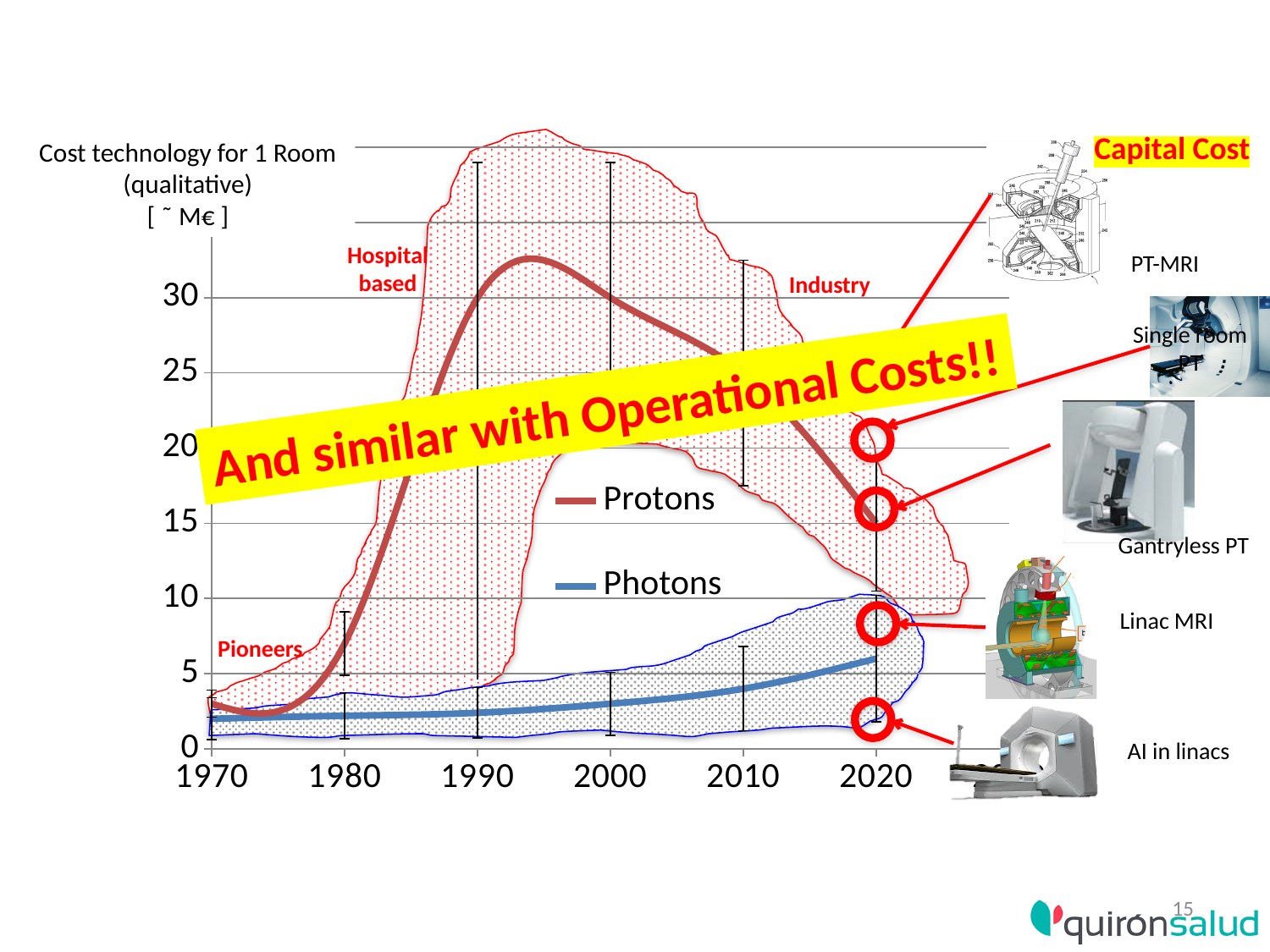
Is the value of the Photons line at 2020 greater or less than 10? less Is the value of the Protons line at 2020 greater or less than 10? greater How many series does the chart legend list? 2 Which series reaches the highest value on the chart? Protons What kind of chart is shown on the slide? line chart At 2020, which series has the larger value, Protons or Photons? Protons What is the label on the vertical axis of the chart? Cost technology for 1 Room (qualitative) [ ~ M€ ] Does the Photons line rise or fall from 1970 to 2020? rise What are the two series named in the chart legend? Protons and Photons Is the value of the Photons line at 1970 greater or less than 5? less How many year labels are shown along the x axis? 6